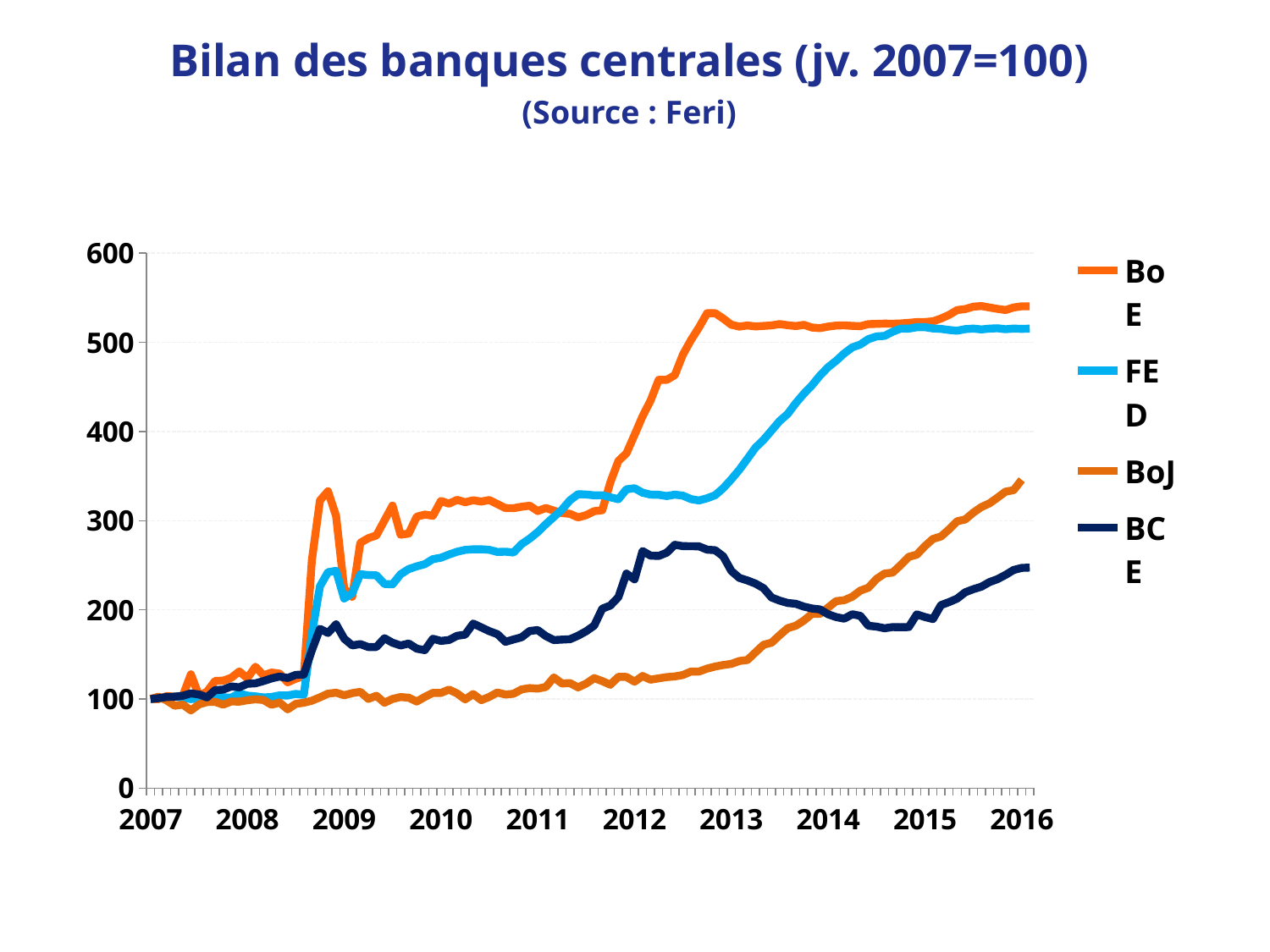
What is the source cited under the chart title? Feri Is the value for BCE in 2016 greater or less than 300? less Which series has the lowest value in 2016? BCE Is the value for FED in 2013 greater or less than 400? less Is the value for BoJ in 2016 greater or less than 300? greater What is the index base value for all series in January 2007, as stated in the title? 100 What kind of chart is shown on the slide? line chart How many series does the legend list? 4 Does the BCE series rise or fall between 2012 and 2014? fall Which is larger in 2013, the value for BoE or the value for FED? BoE Does the BoJ series rise or fall between 2013 and 2016? rise